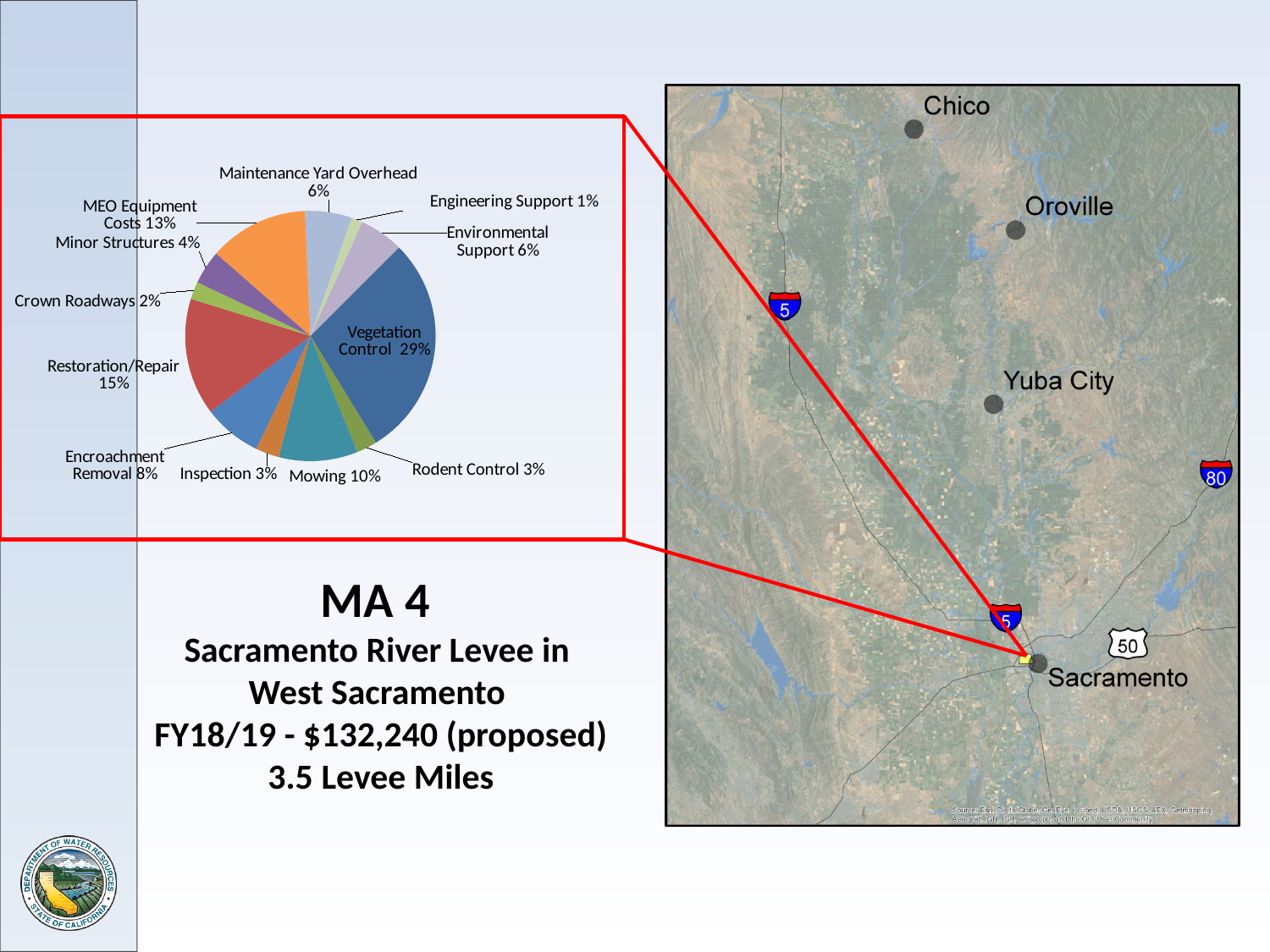
Which is larger, Mowing or Encroachment Removal? Mowing What percentage is shown for Maintenance Yard Overhead? 6% What type of chart is shown on the slide? pie chart What is the proposed FY18/19 budget amount stated below the chart? $132,240 What is the difference in percentage points between Vegetation Control and Restoration/Repair? 14 How many categories are shown in the pie chart? 12 What share of the pie does Vegetation Control represent? 29% Which category has the largest slice of the pie? Vegetation Control What percentage is shown for Restoration/Repair? 15% What percentage is shown for MEO Equipment Costs? 13% Which category has the smallest slice of the pie? Engineering Support What is the combined percentage of Inspection and Rodent Control? 6%